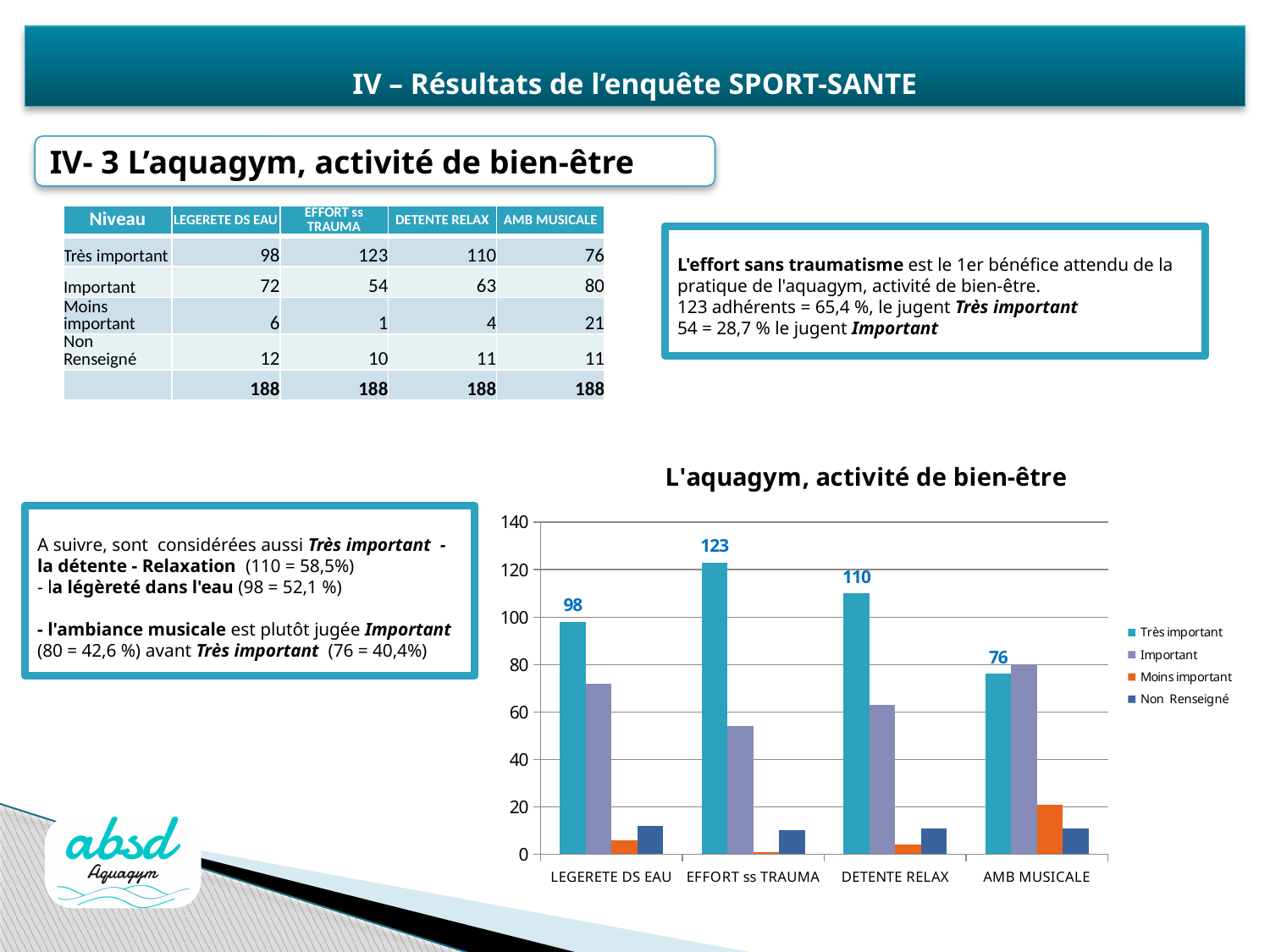
What is the value of 'Très important' for EFFORT ss TRAUMA? 123 Which category has the highest 'Très important' value? EFFORT ss TRAUMA What type of chart is shown on the slide? Bar chart How many categories are shown on the x axis of the chart? 4 What is the title of the chart? L'aquagym, activité de bien-être What is the value of 'Très important' for AMB MUSICALE? 76 How many series does the chart legend list? 4 Which category has the lowest 'Très important' value? AMB MUSICALE Which is larger: the 'Très important' value for DETENTE RELAX or for LEGERETE DS EAU? DETENTE RELAX What is the difference between the 'Très important' values for EFFORT ss TRAUMA and LEGERETE DS EAU? 25 Is the 'Moins important' value for AMB MUSICALE greater or less than 40? less Is the 'Important' value for AMB MUSICALE greater or less than 60? greater